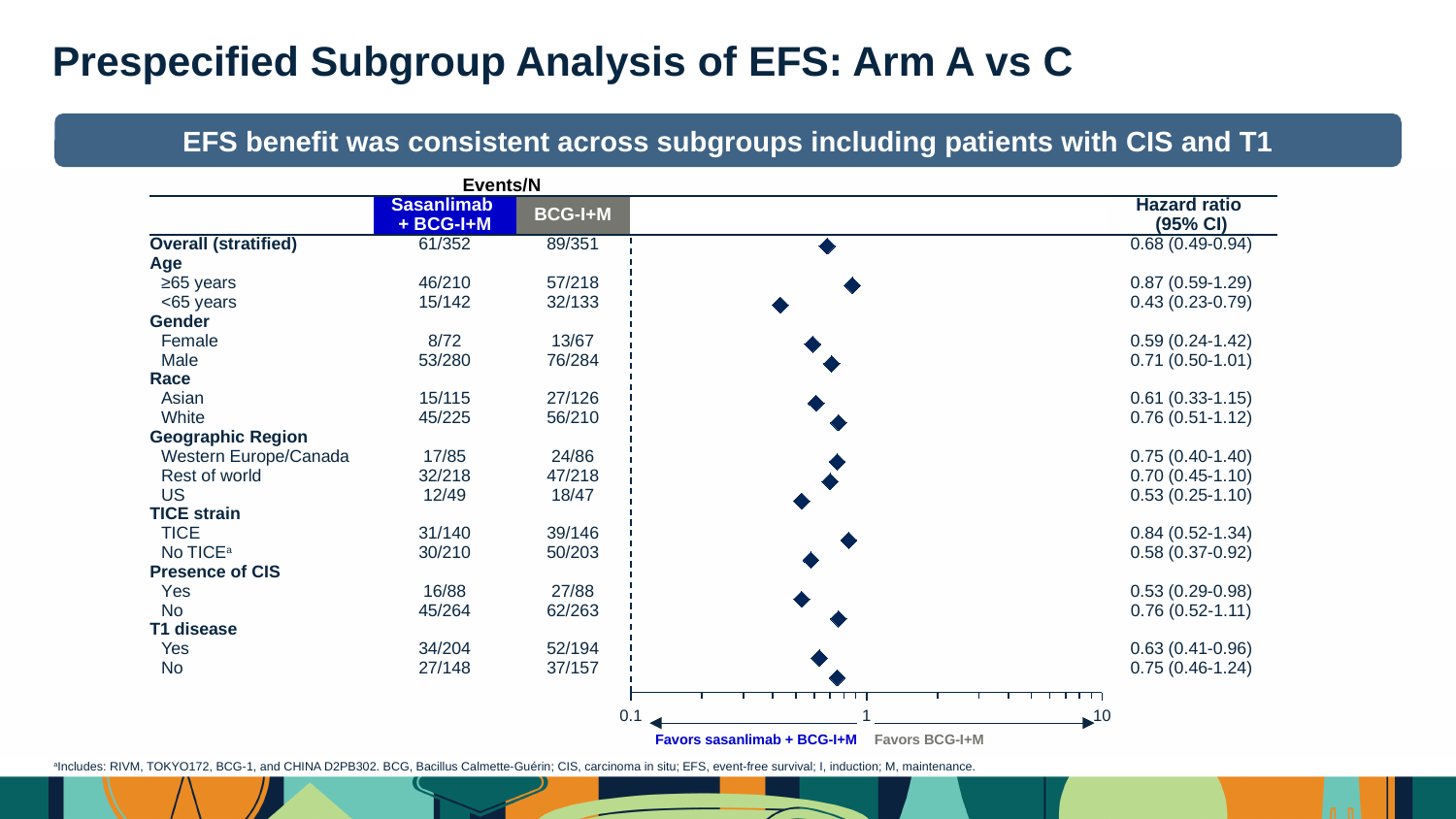
What is the hazard ratio (95% CI) for the Overall (stratified) analysis? 0.68 (0.49-0.94) Which subgroup has the lowest hazard ratio point estimate? <65 years What is the difference between the hazard ratio point estimates for ≥65 years and <65 years? 0.44 How many hazard ratio points are plotted in the forest plot, including the Overall row? 16 What kind of chart is shown on the slide? Forest plot Which has the larger hazard ratio point estimate, TICE or No TICE? TICE What is the hazard ratio (95% CI) for patients <65 years? 0.43 (0.23-0.79) Which subgroup has the highest hazard ratio point estimate? ≥65 years What are the Events/N for BCG-I+M in the Male subgroup? 76/284 What are the Events/N for Sasanlimab + BCG-I+M in the Overall (stratified) row? 61/352 Is the hazard ratio point estimate for the US subgroup greater or less than 1? less What is the hazard ratio (95% CI) for patients with presence of CIS (Yes)? 0.53 (0.29-0.98)